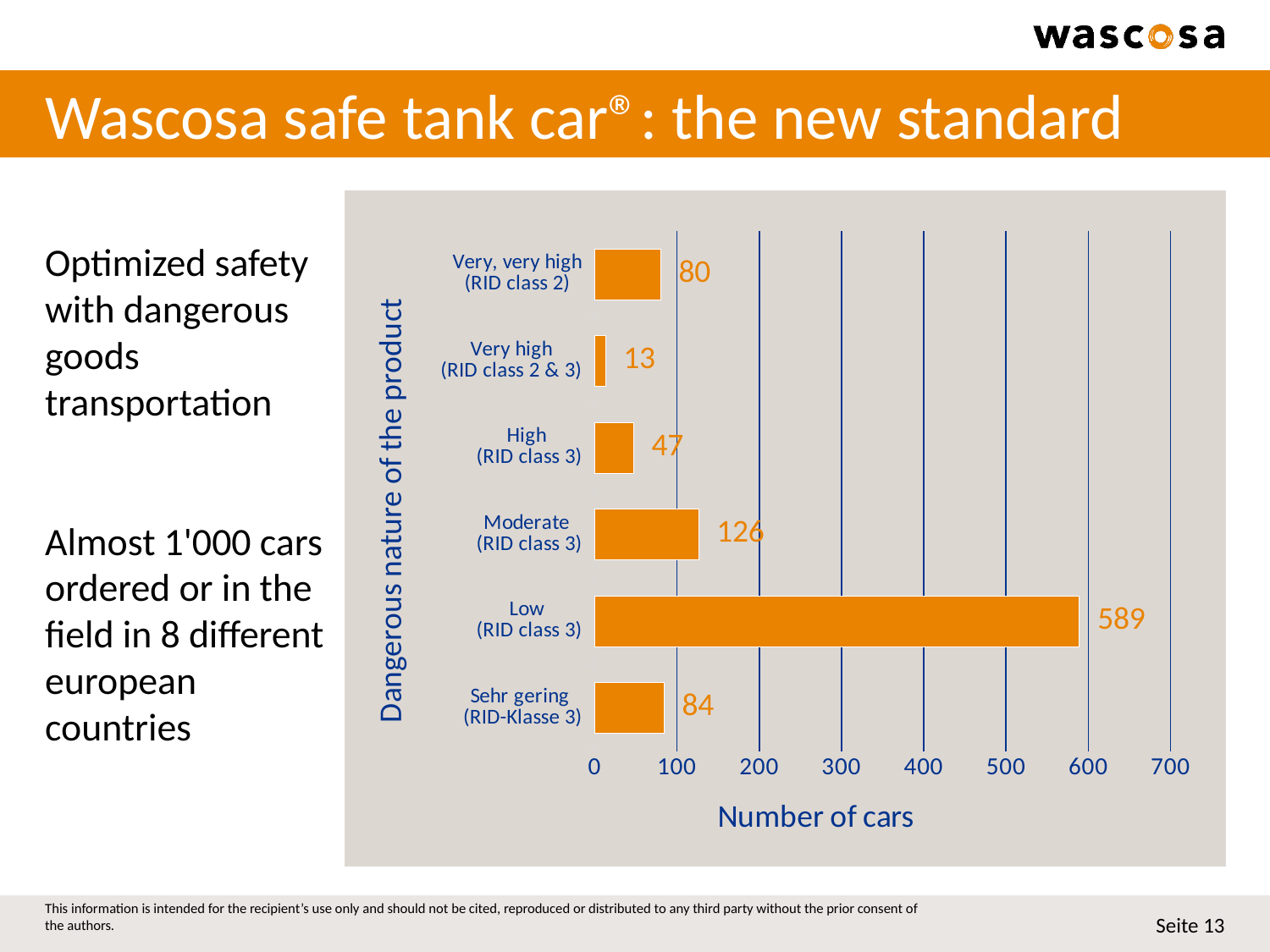
What type of chart is shown on the slide? Bar chart What is the difference in number of cars between the Low (RID class 3) and Moderate (RID class 3) categories? 463 What is the value for the Moderate (RID class 3) category? 126 Which has more cars: Very, very high (RID class 2) or High (RID class 3)? Very, very high (RID class 2) What is the label of the vertical axis of the chart? Dangerous nature of the product What is the label of the horizontal axis of the chart? Number of cars How many categories are plotted on the chart? 6 Which category has the lowest number of cars? Very high (RID class 2 & 3) What is the number of cars for the Very high (RID class 2 & 3) category? 13 How many cars are shown for the Low (RID class 3) category? 589 Which category has the highest number of cars? Low (RID class 3) What is the number of cars for Sehr gering (RID-Klasse 3)? 84